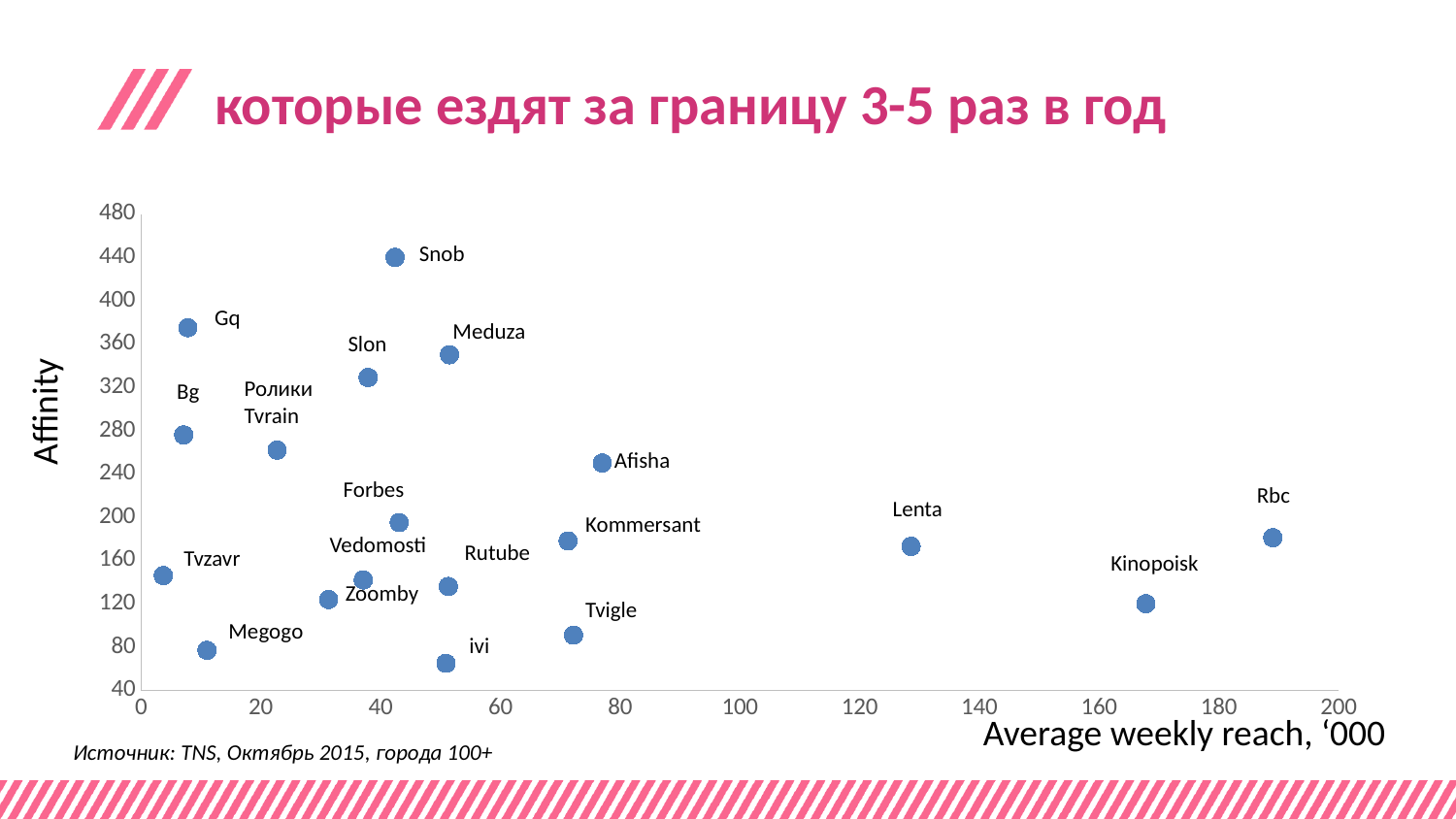
Is the Affinity value for Snob greater or less than 400? greater Which point has the highest average weekly reach? Rbc What kind of chart is shown on the slide? scatter chart Which point has the lowest Affinity value? ivi How many labeled points are plotted on the chart? 19 Is the Affinity value for Kinopoisk greater or less than 160? less Which point has the lowest average weekly reach? Tvzavr Which has the higher Affinity value, Gq or Bg? Gq Which point has the highest Affinity value? Snob What is the label of the vertical axis? Affinity Is the average weekly reach for Lenta greater or less than 120? greater Which has the higher average weekly reach, Kinopoisk or Lenta? Kinopoisk